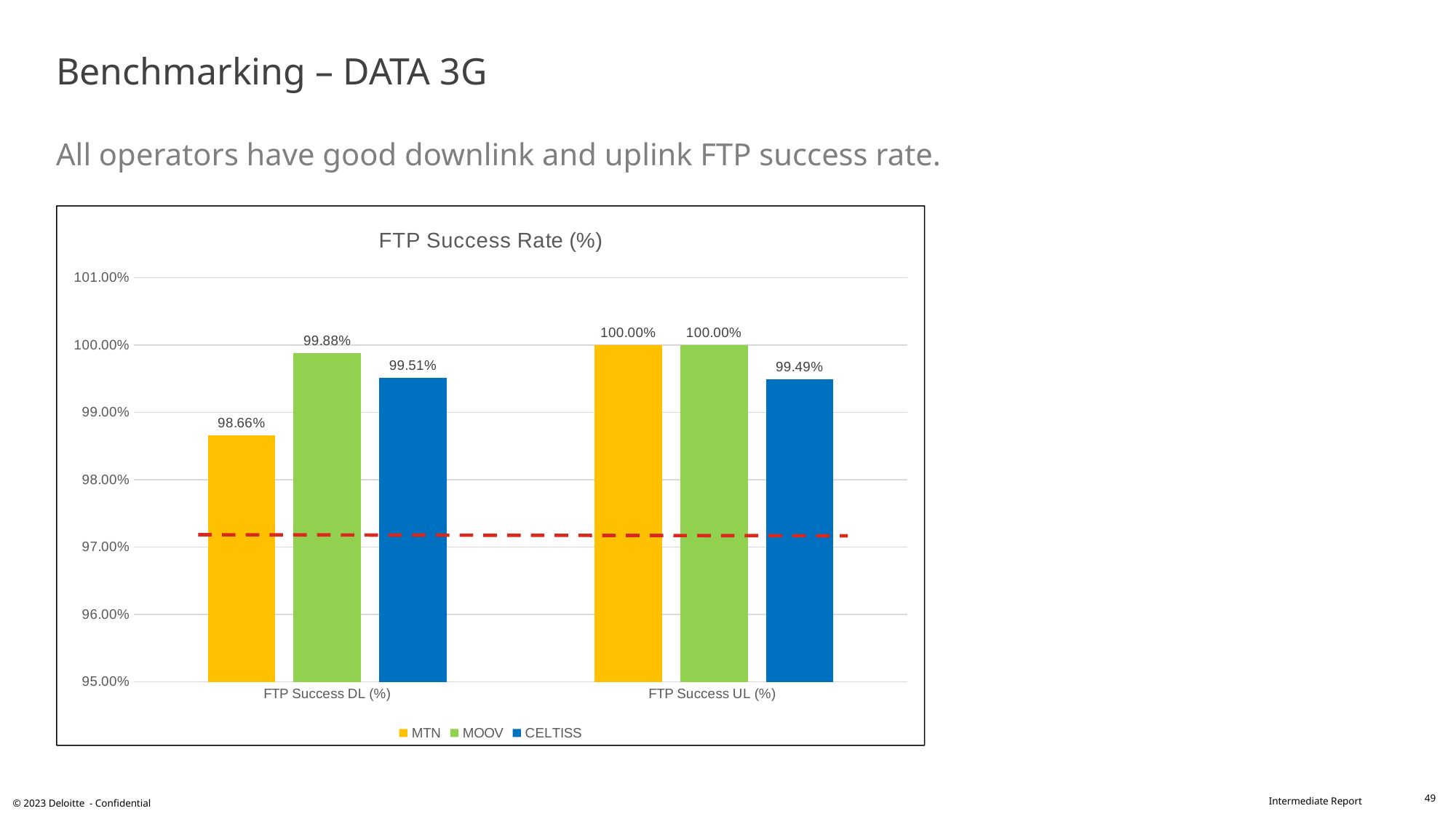
What is the FTP Success UL (%) value for CELTISS? 99.49% Which operator has the highest FTP Success DL (%)? MOOV How many series does the legend list? 3 What is the title of the chart? FTP Success Rate (%) What is the FTP Success DL (%) value for MOOV? 99.88% What kind of chart is shown on the slide? Bar chart Which operator has the lowest FTP Success UL (%)? CELTISS What is the difference between MOOV's and MTN's FTP Success DL (%) values? 1.22% Which operator has the lowest FTP Success DL (%)? MTN What is the difference between MTN's FTP Success UL (%) and FTP Success DL (%) values? 1.34% What is the FTP Success DL (%) value for MTN? 98.66% Which is larger: CELTISS's FTP Success DL (%) or CELTISS's FTP Success UL (%)? FTP Success DL (%)